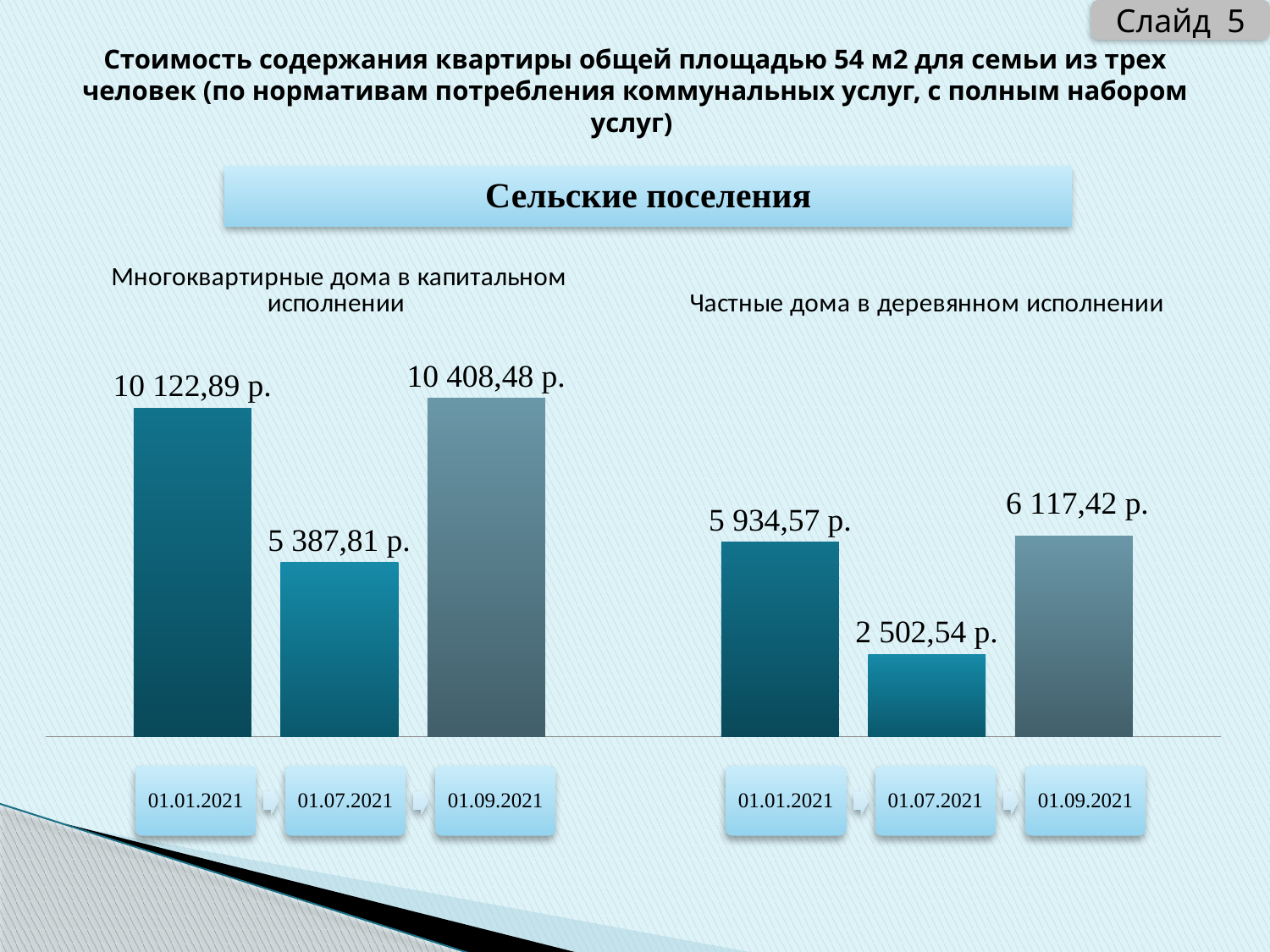
In the chart 'Многоквартирные дома в капитальном исполнении', which date has the highest value? 01.09.2021 In the chart 'Частные дома в деревянном исполнении', what is the difference between the values for 01.01.2021 and 01.07.2021? 3 432,03 р. In the chart 'Частные дома в деревянном исполнении', what is the value for 01.07.2021? 2 502,54 р. In the chart 'Частные дома в деревянном исполнении', what is the value for 01.09.2021? 6 117,42 р. How many bars are in the chart 'Многоквартирные дома в капитальном исполнении'? 3 In the chart 'Многоквартирные дома в капитальном исполнении', what is the value for 01.07.2021? 5 387,81 р. What kind of chart is 'Частные дома в деревянном исполнении'? Bar chart In the chart 'Частные дома в деревянном исполнении', which date has the lowest value? 01.07.2021 What is the heading shown in the blue box above the two charts? Сельские поселения In the chart 'Многоквартирные дома в капитальном исполнении', what is the difference between the values for 01.09.2021 and 01.01.2021? 285,59 р. In the chart 'Многоквартирные дома в капитальном исполнении', what is the value for 01.01.2021? 10 122,89 р. In the chart 'Частные дома в деревянном исполнении', which is larger: the value for 01.01.2021 or for 01.09.2021? 01.09.2021